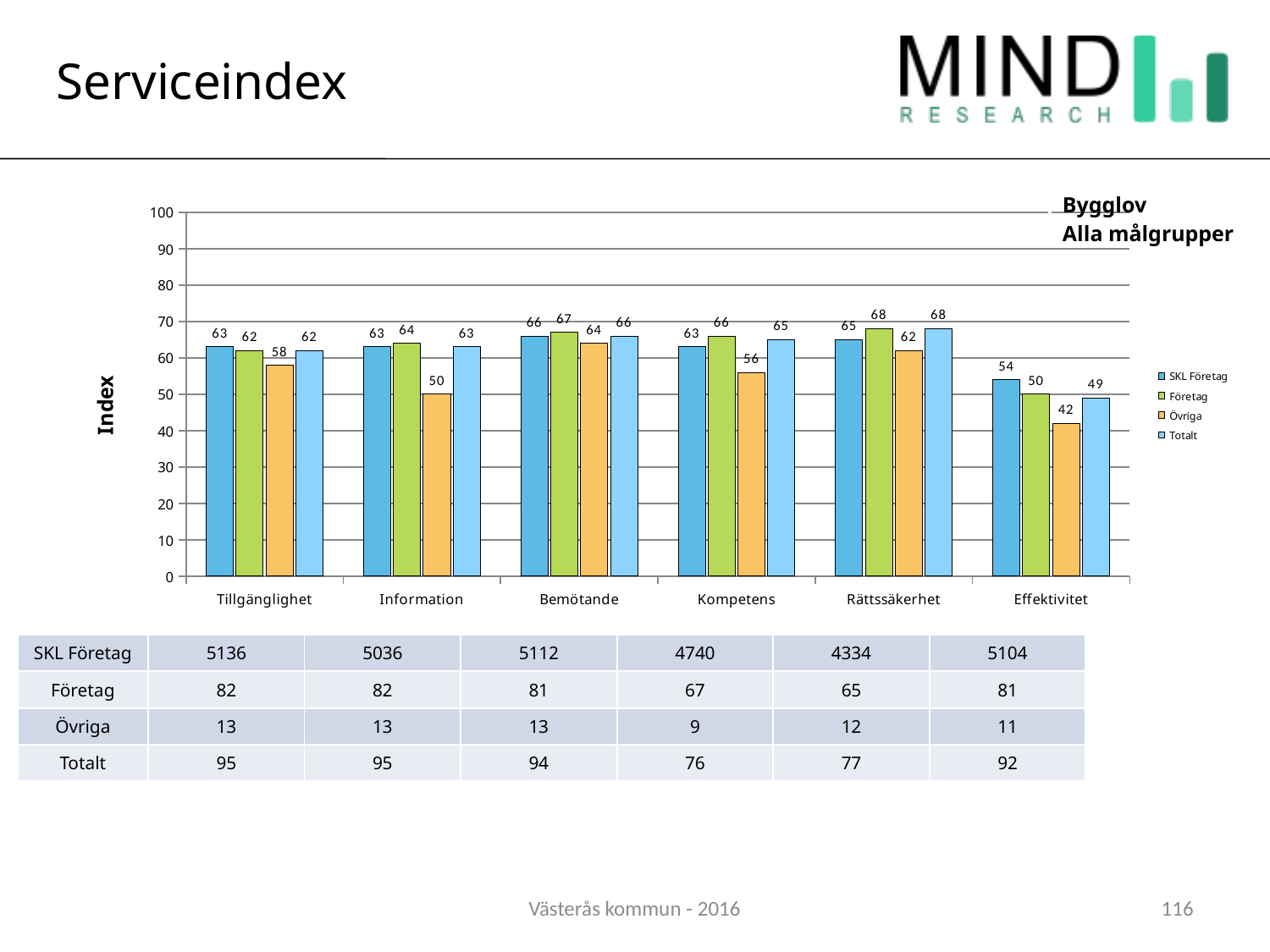
What is the label on the vertical axis of the chart? Index How many categories are shown on the x axis? 6 What is the value for Övriga in the Information category? 50 What is the value for Totalt in the Effektivitet category? 49 Which category has the highest value for Företag? Rättssäkerhet What is the value for SKL Företag in the Bemötande category? 66 What is the difference between the Företag and Övriga values in the Kompetens category? 10 How many series does the legend list? 4 What is the value for Företag in the Rättssäkerhet category? 68 Which category has the lowest value for Övriga? Effektivitet Which is larger: the Totalt value for Tillgänglighet or the Totalt value for Kompetens? Kompetens What kind of chart is shown on the slide? bar chart